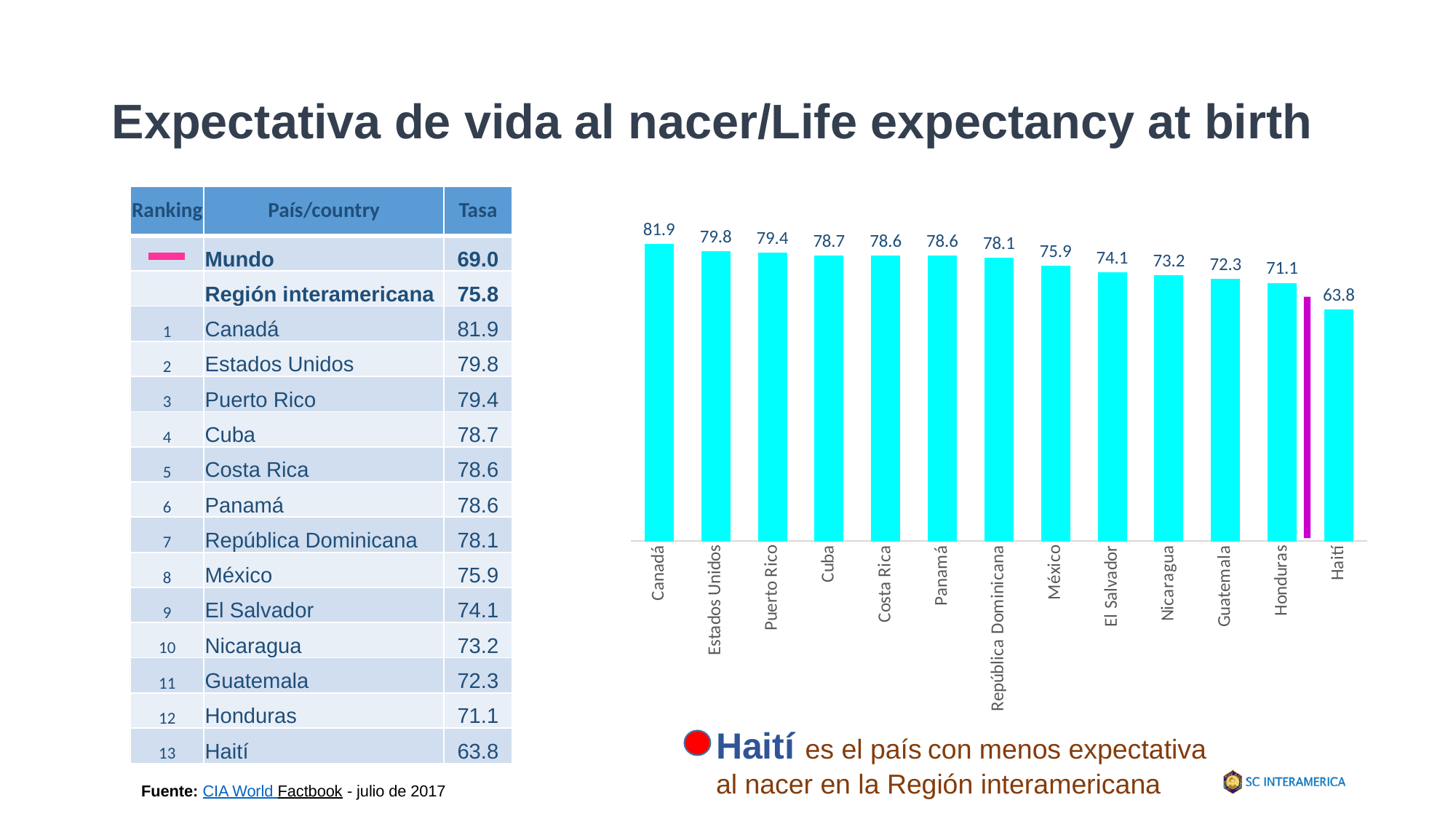
What is the value shown for Haití in the chart? 63.8 What is the value shown for México in the chart? 75.9 Which has a higher value, Cuba or El Salvador? Cuba Which country has the lowest value in the chart? Haití What is the life expectancy value shown for Canadá in the chart? 81.9 What kind of chart is shown on the slide? Bar chart Which has a higher value, Nicaragua or Guatemala? Nicaragua What is the difference between the values for Canadá and Haití? 18.1 What is the difference between the values for Estados Unidos and Puerto Rico? 0.4 Which country has the highest value in the chart? Canadá How many countries are plotted in the chart? 13 Do the values rise or fall from left to right across the chart? Fall